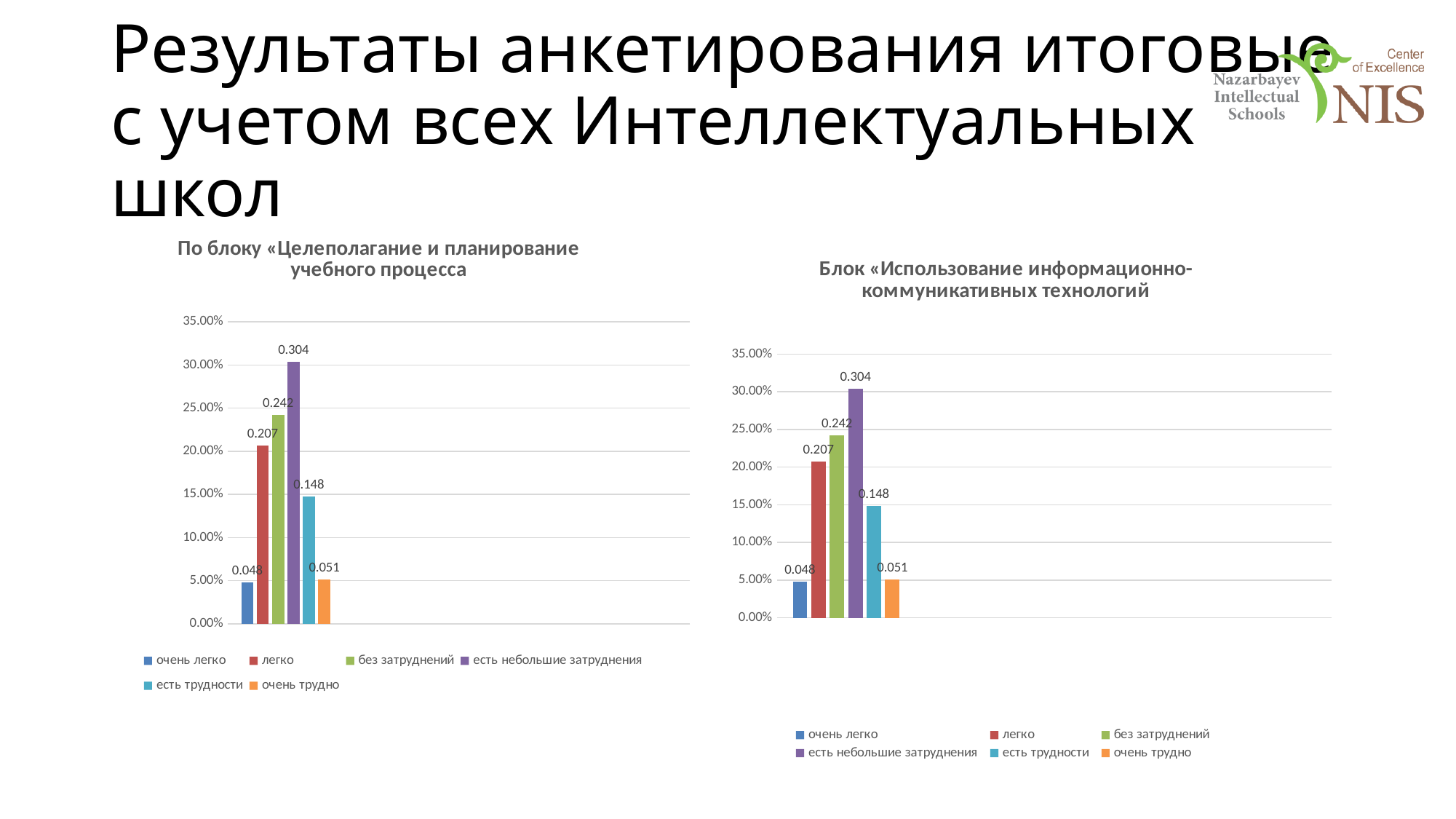
In the right chart «Использование информационно-коммуникативных технологий», what is the value for «легко»? 0.207 In the right chart «Использование информационно-коммуникативных технологий», which series has the highest value? есть небольшие затруднения What kind of chart is the right chart «Использование информационно-коммуникативных технологий»? bar chart What colour is the bar for «есть небольшие затруднения» in the right chart «Использование информационно-коммуникативных технологий»? purple In the left chart «Целеполагание и планирование учебного процесса», which series has the lowest value? очень легко In the right chart «Использование информационно-коммуникативных технологий», what is the difference between «без затруднений» and «есть трудности»? 0.094 In the left chart «Целеполагание и планирование учебного процесса», what is the value for «очень легко»? 0.048 In the left chart «Целеполагание и планирование учебного процесса», what is the value for «есть небольшие затруднения»? 0.304 In the left chart «Целеполагание и планирование учебного процесса», which is larger: «легко» or «есть трудности»? легко In the right chart «Использование информационно-коммуникативных технологий», is the value for «без затруднений» greater or less than 20.00%? greater In the left chart «Целеполагание и планирование учебного процесса», what is the difference between «очень трудно» and «очень легко»? 0.003 How many series does the legend of the left chart «Целеполагание и планирование учебного процесса» list? 6